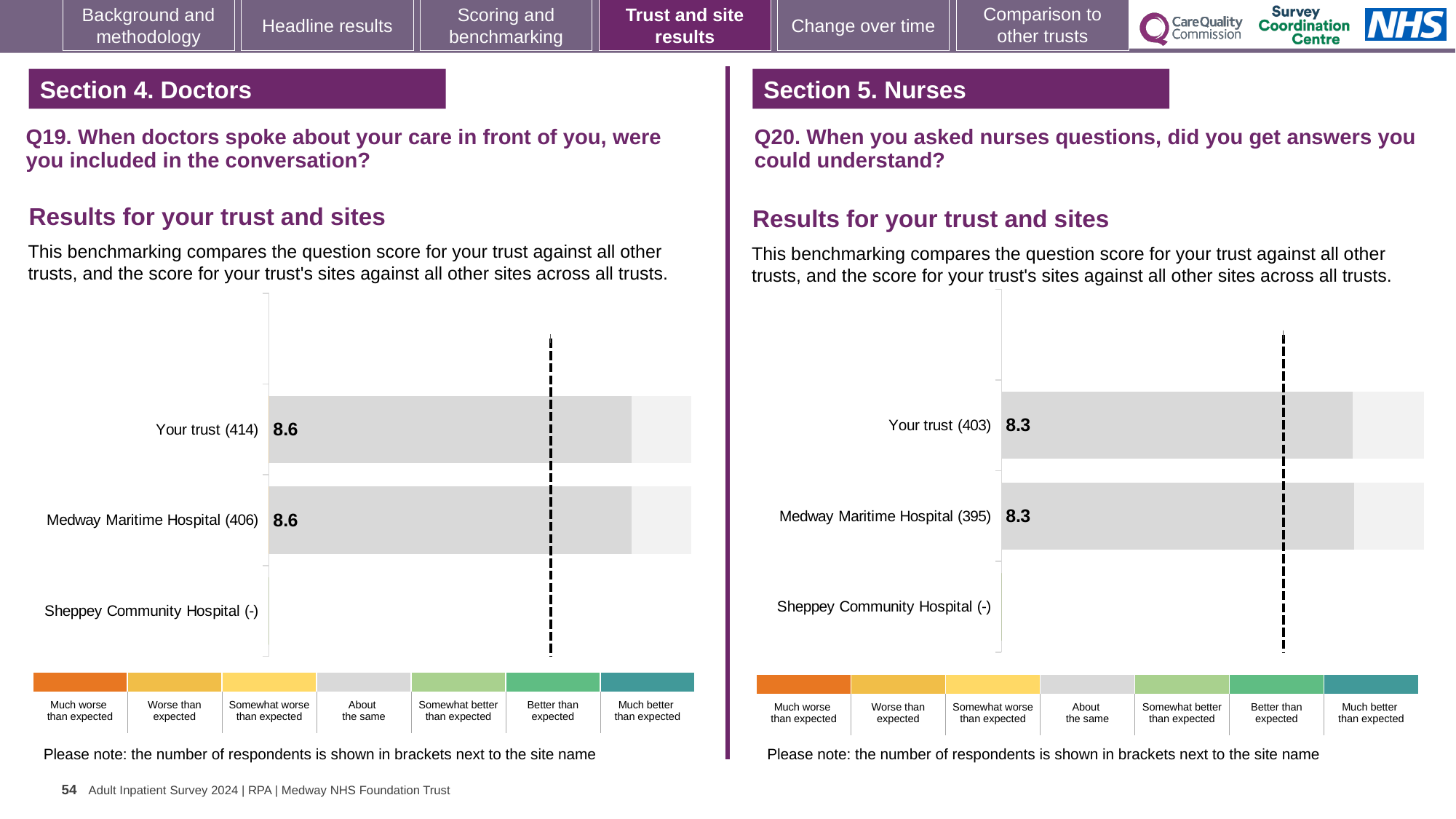
Is the score for Your trust in the Q19 chart on the left larger or smaller than the score for Your trust in the Q20 chart on the right? Larger In the Q19 chart on the left, what is the score for Medway Maritime Hospital? 8.6 What is the difference between the Your trust score in the Q19 chart on the left and the Your trust score in the Q20 chart on the right? 0.3 In the Q20 chart on the right, what is the score for Your trust? 8.3 How many categories (rows) are listed in the Q20 chart on the right? 3 In the Q19 chart on the left, what is the score for Your trust? 8.6 In the Q20 chart on the right, what is the score for Medway Maritime Hospital? 8.3 In the Q20 chart on the right, how many respondents are shown in brackets for Your trust? 403 What kind of chart is used for the Q19 results on the left? Bar chart How many categories (rows) are listed in the Q19 chart on the left? 3 In the Q19 chart on the left, which category has no score shown? Sheppey Community Hospital (-)